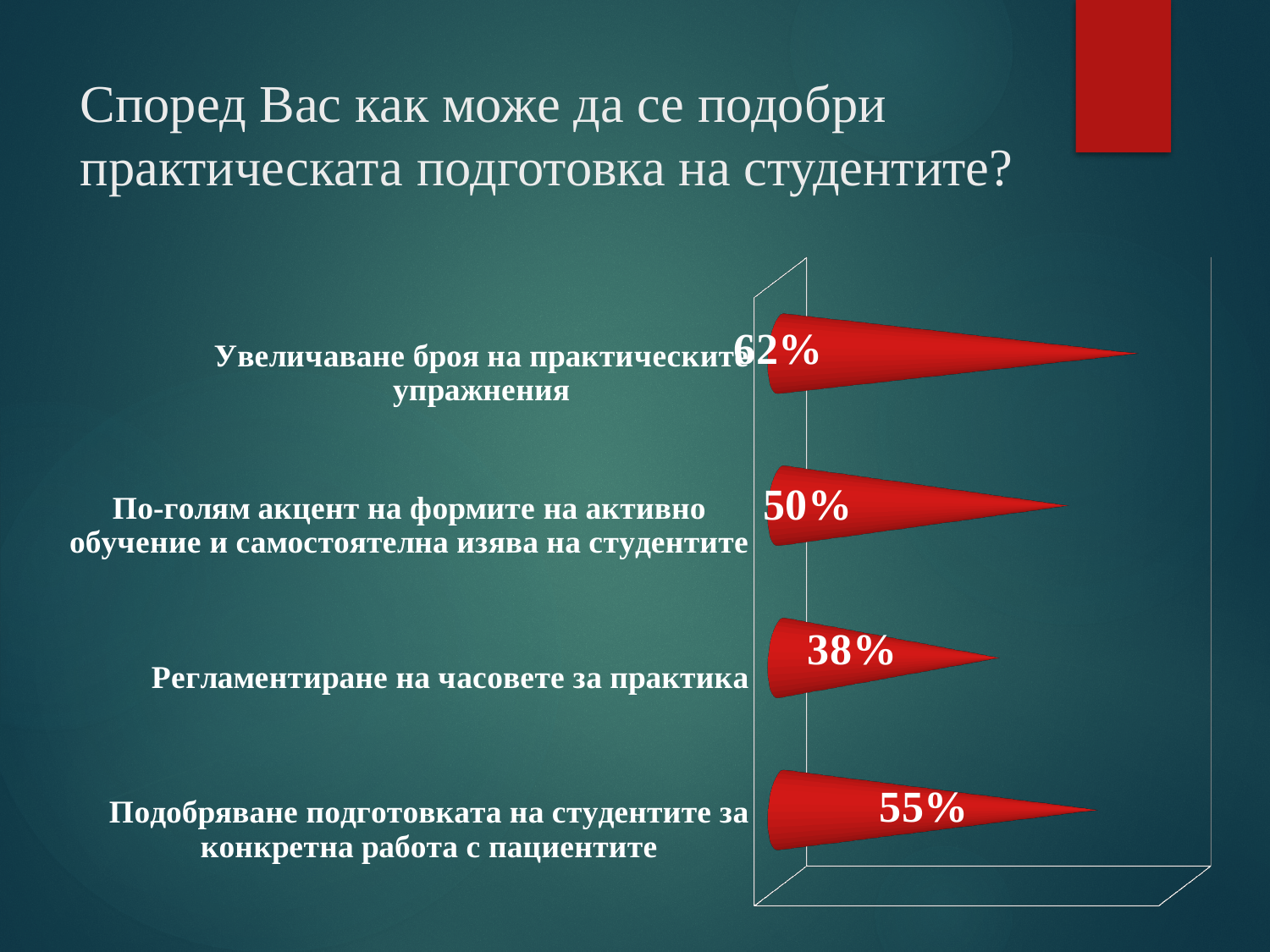
How many categories are shown in the chart? 4 What value is shown for "Подобряване подготовката на студентите за конкретна работа с пациентите"? 55% Which is larger: the value for "По-голям акцент на формите на активно обучение и самостоятелна изява на студентите" or for "Подобряване подготовката на студентите за конкретна работа с пациентите"? Подобряване подготовката на студентите за конкретна работа с пациентите What is the difference between the values for "Подобряване подготовката на студентите за конкретна работа с пациентите" and "По-голям акцент на формите на активно обучение и самостоятелна изява на студентите"? 5% What colour are the bars in the chart? Red What value is shown for "По-голям акцент на формите на активно обучение и самостоятелна изява на студентите"? 50% What value is shown for "Регламентиране на часовете за практика"? 38% Which category has the highest value? Увеличаване броя на практическите упражнения What value is shown for "Увеличаване броя на практическите упражнения"? 62% Which category has the lowest value? Регламентиране на часовете за практика What kind of chart is shown on the slide? Bar chart What is the difference between the values for "Увеличаване броя на практическите упражнения" and "Регламентиране на часовете за практика"? 24%